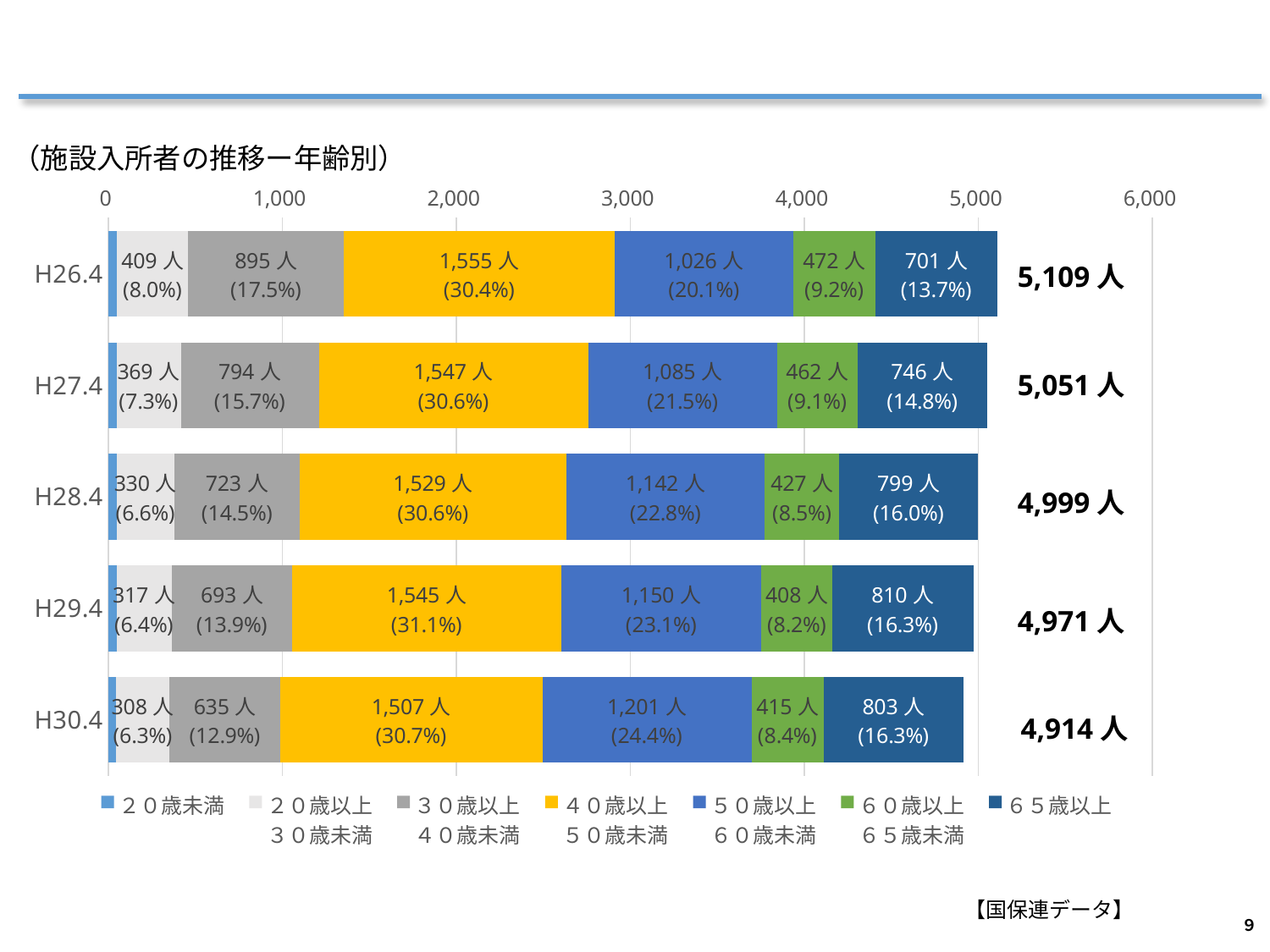
Do the total numbers of residents rise or fall from H26.4 to H30.4? Fall What is the value for 40歳以上50歳未満 in H26.4? 1,555 人 How many years (bars) are shown in the chart? 5 Which year has the highest total number of residents? H26.4 Which is larger: the 30歳以上40歳未満 value in H26.4 or in H30.4? H26.4 What is the total number of residents shown for the H28.4 bar? 4,999 人 What is the title of the chart? （施設入所者の推移ー年齢別） What percentage share is shown for 65歳以上 in H30.4? 16.3% What is the difference between the 50歳以上60歳未満 values for H30.4 and H26.4? 175 人 What kind of chart is shown on the slide? Stacked bar chart Which year has the lowest total number of residents? H30.4 How many series does the legend list? 7